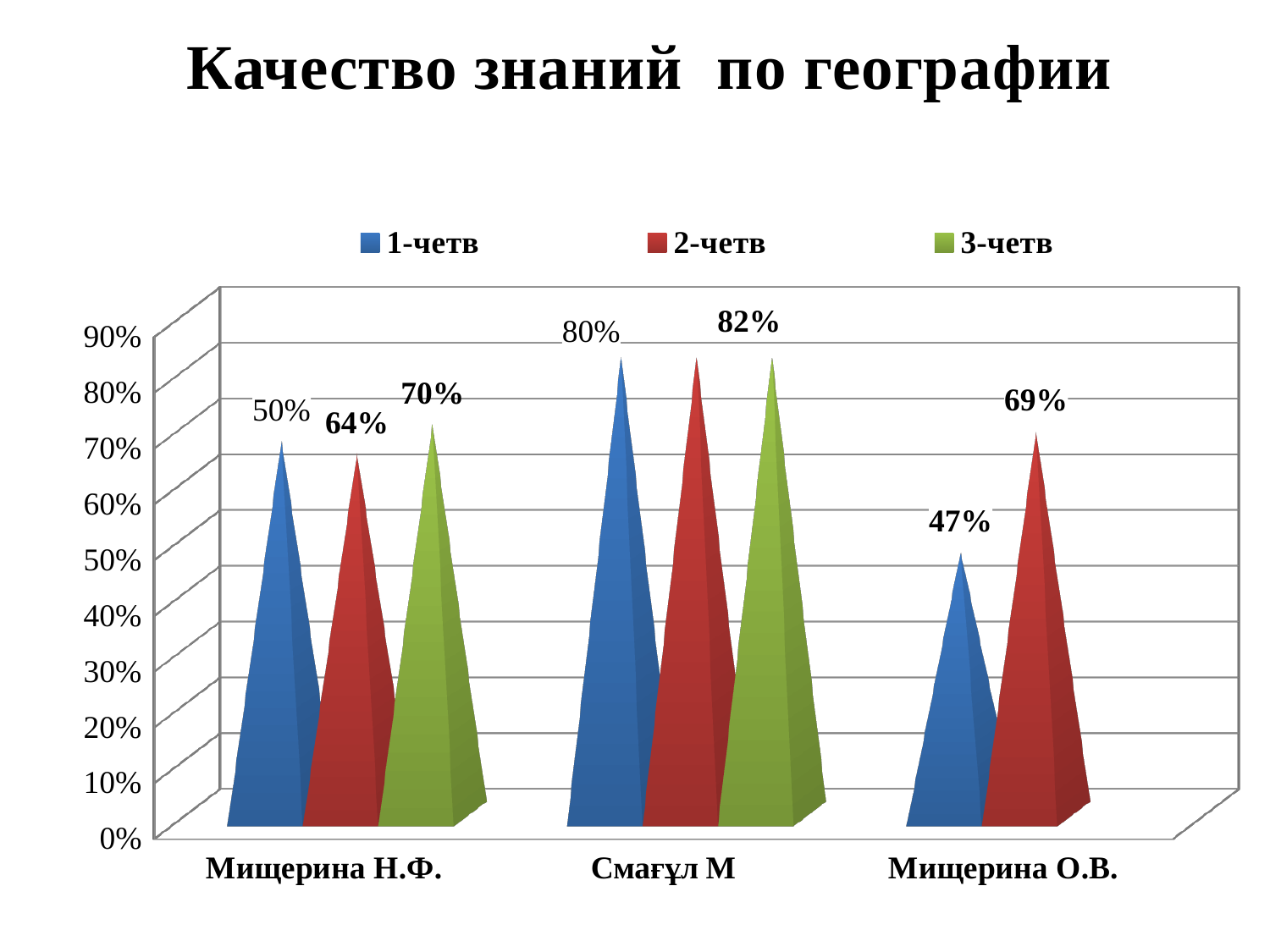
What kind of chart is shown on the slide? Bar chart What is the value for Смағұл М in the 1-четв series? 80% How many categories are shown on the x axis? 3 What is the difference between the 3-четв and 1-четв values for Мищерина Н.Ф.? 20 percentage points For Мищерина О.В., which is larger: the 1-четв value or the 2-четв value? 2-четв What is the value for Мищерина Н.Ф. in the 1-четв series? 50% What is the value for Мищерина О.В. in the 1-четв series? 47% How many series does the legend list? 3 What is the value for Мищерина Н.Ф. in the 3-четв series? 70% Which category has the highest value in the 1-четв series? Смағұл М What is the value for Мищерина О.В. in the 2-четв series? 69% Which category has the lowest value in the 1-четв series? Мищерина О.В.